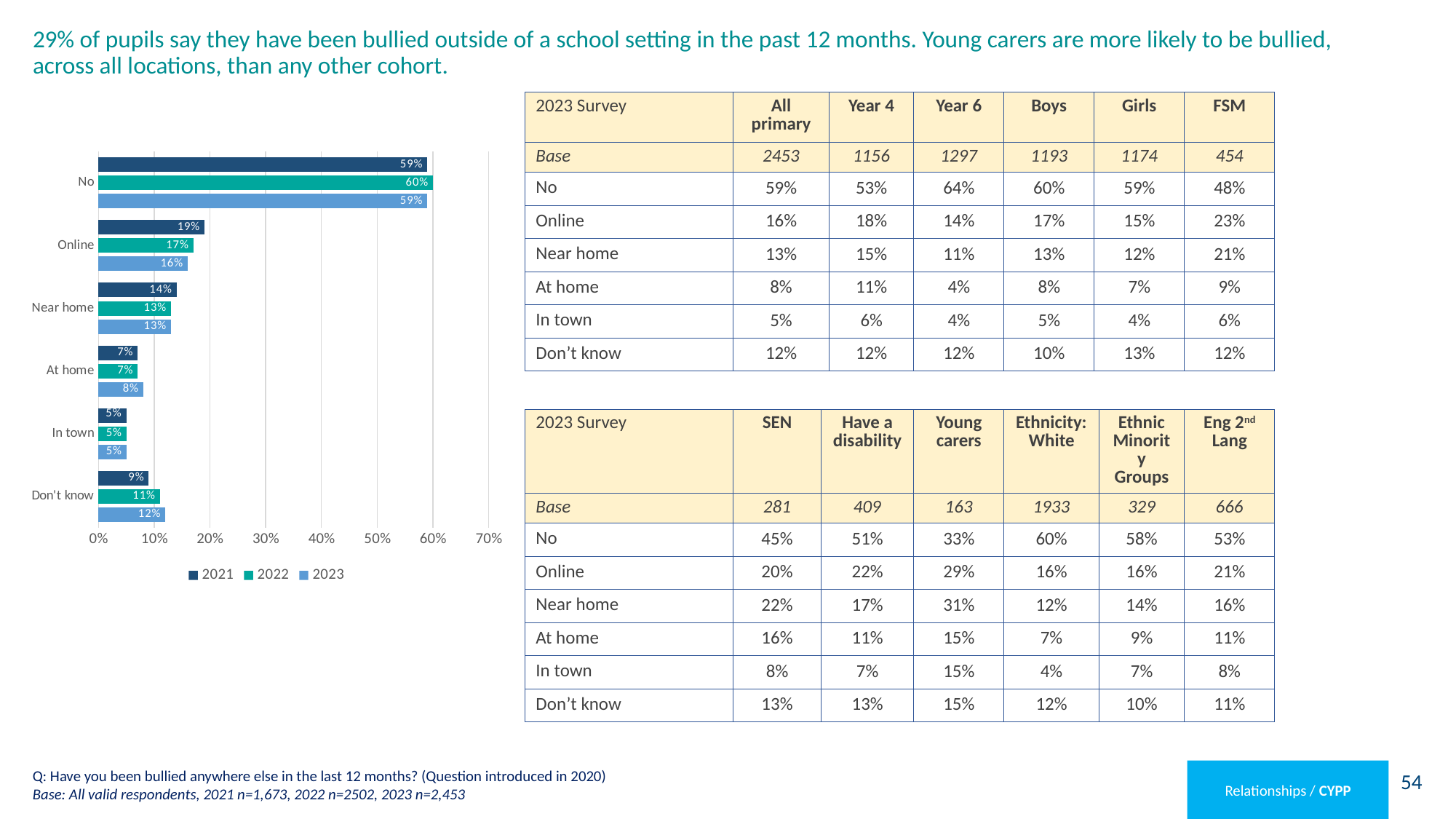
Which category has the highest values in the chart? No How many series does the chart legend list? 3 What is the 2022 value for 'No' in the chart? 60% What is the 2023 value for 'Don't know' in the chart? 12% What kind of chart is shown on the left of the slide? bar chart Which is larger for 'Don't know': the 2021 value or the 2023 value? 2023 Is the 2023 value for 'No' greater or less than 50%? greater How many categories are shown on the chart's vertical axis? 6 Which category has the lowest values in the chart? In town What is the 2021 value for 'Online' in the chart? 19% What is the difference between the 2021 and 2023 values for 'Online'? 3% Which series in the chart legend is shown in dark navy blue? 2021